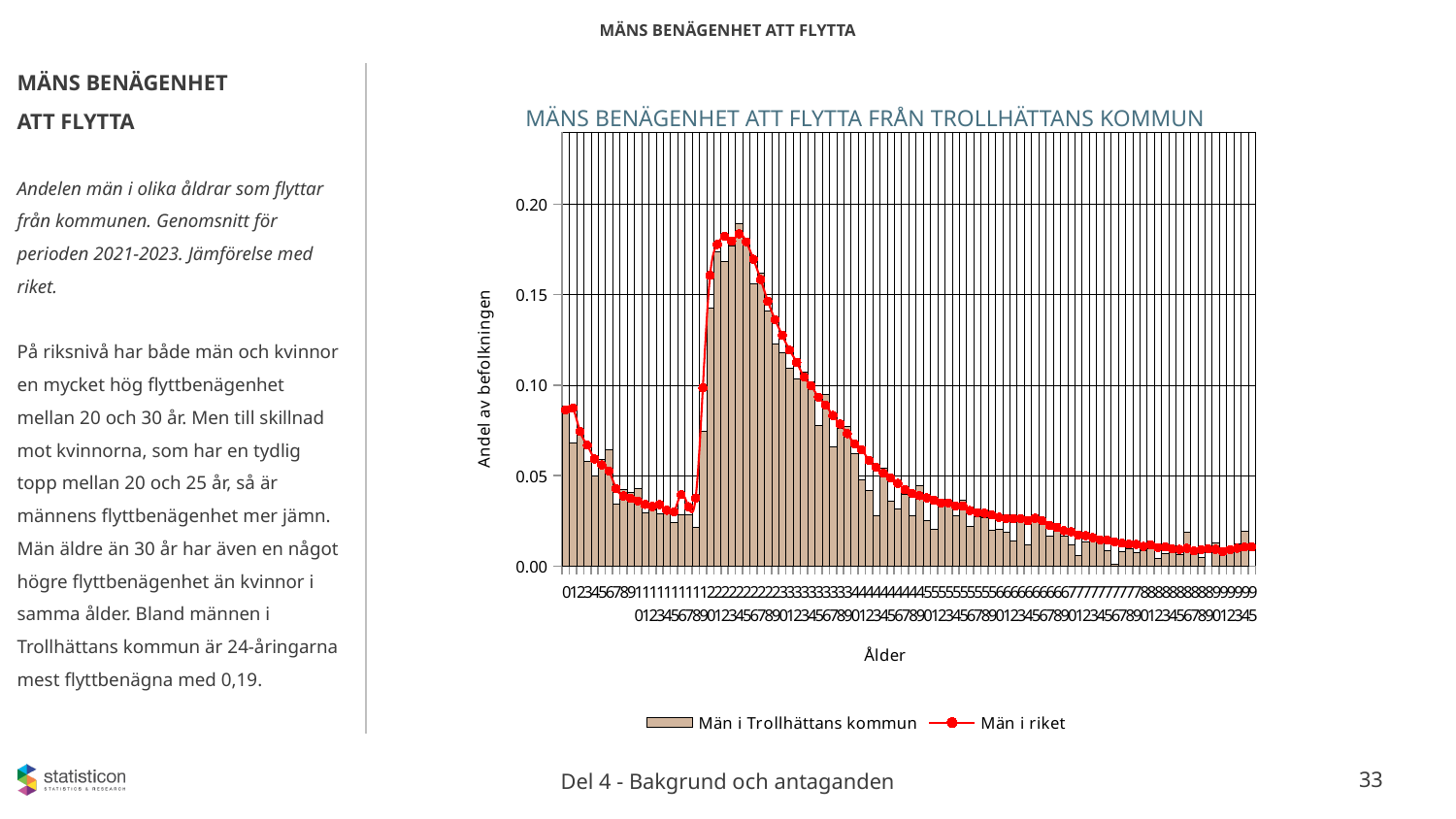
Which series is drawn as a red line with markers? Män i riket What kind of chart is used to show the series Män i Trollhättans kommun? Bar chart What is the label of the vertical axis of the chart? Andel av befolkningen Is the highest bar for Män i Trollhättans kommun greater or less than 0.15? greater Is the value for Män i riket at age 10 greater or less than 0.05? less How many series does the chart legend list? 2 Is the value for Män i Trollhättans kommun at age 50 greater or less than 0.05? less What is the title of the chart? MÄNS BENÄGENHET ATT FLYTTA FRÅN TROLLHÄTTANS KOMMUN According to the slide, at which age are men in Trollhättans kommun most likely to move (the highest bar)? 24 Between ages 25 and 60, do the values for Män i riket rise or fall as age increases? fall